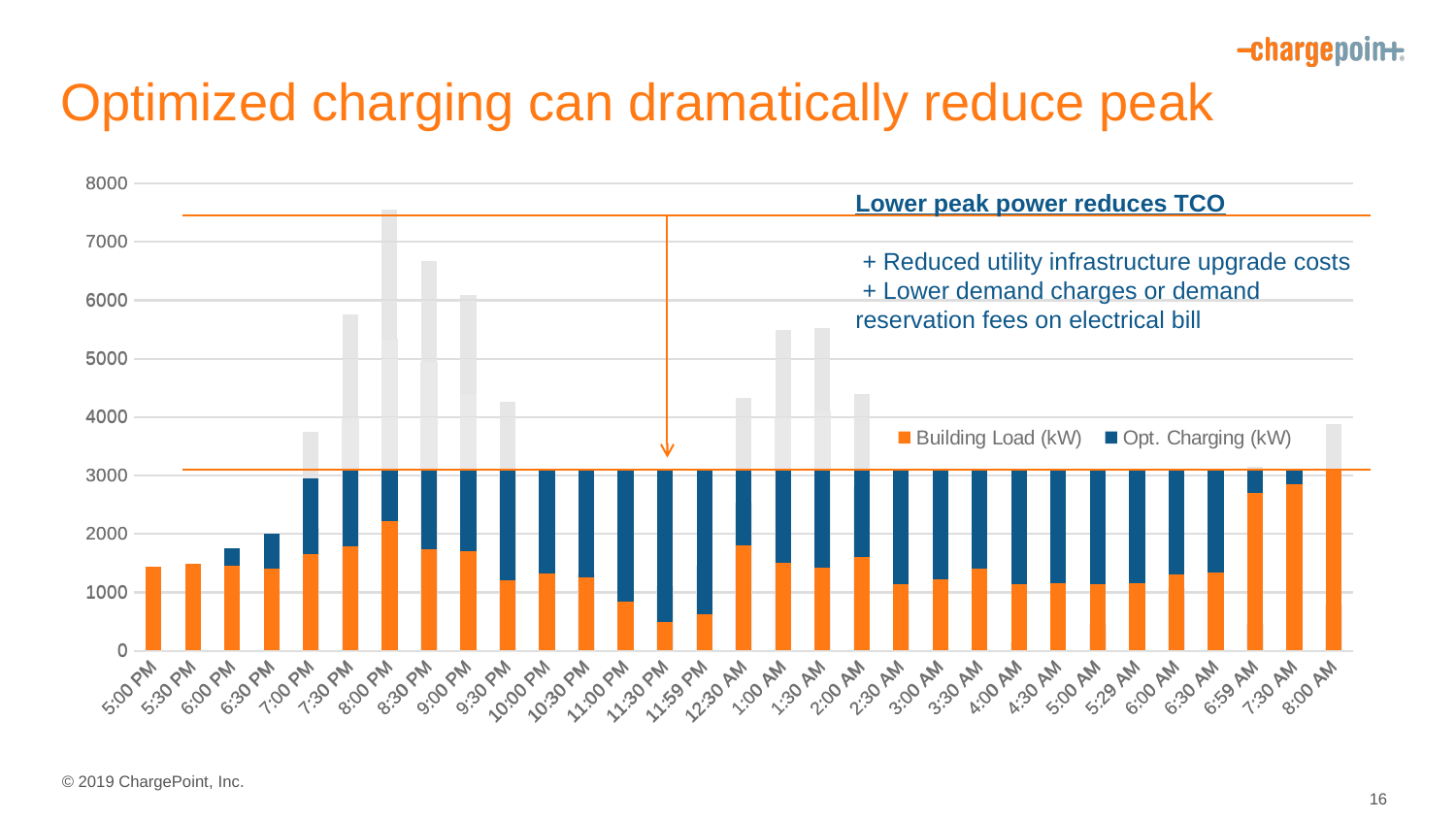
Is the Building Load (kW) value at 5:00 PM greater or less than 1000? greater Is the Building Load (kW) value at 11:30 PM greater or less than 1000? less At which time is the Building Load (kW) lowest? 11:30 PM What are the two series named in the chart legend? Building Load (kW) and Opt. Charging (kW) How many time categories are shown along the x axis? 31 How many series does the chart legend list? 2 Is the Building Load (kW) value at 8:00 PM greater or less than 2000? greater Which colour represents Building Load (kW) in the chart? Orange Does the Building Load (kW) rise or fall from 5:00 PM to 8:00 PM? Rise What kind of chart is shown on the slide? Stacked bar chart Which has the larger Building Load (kW): 7:00 PM or 8:00 PM? 8:00 PM